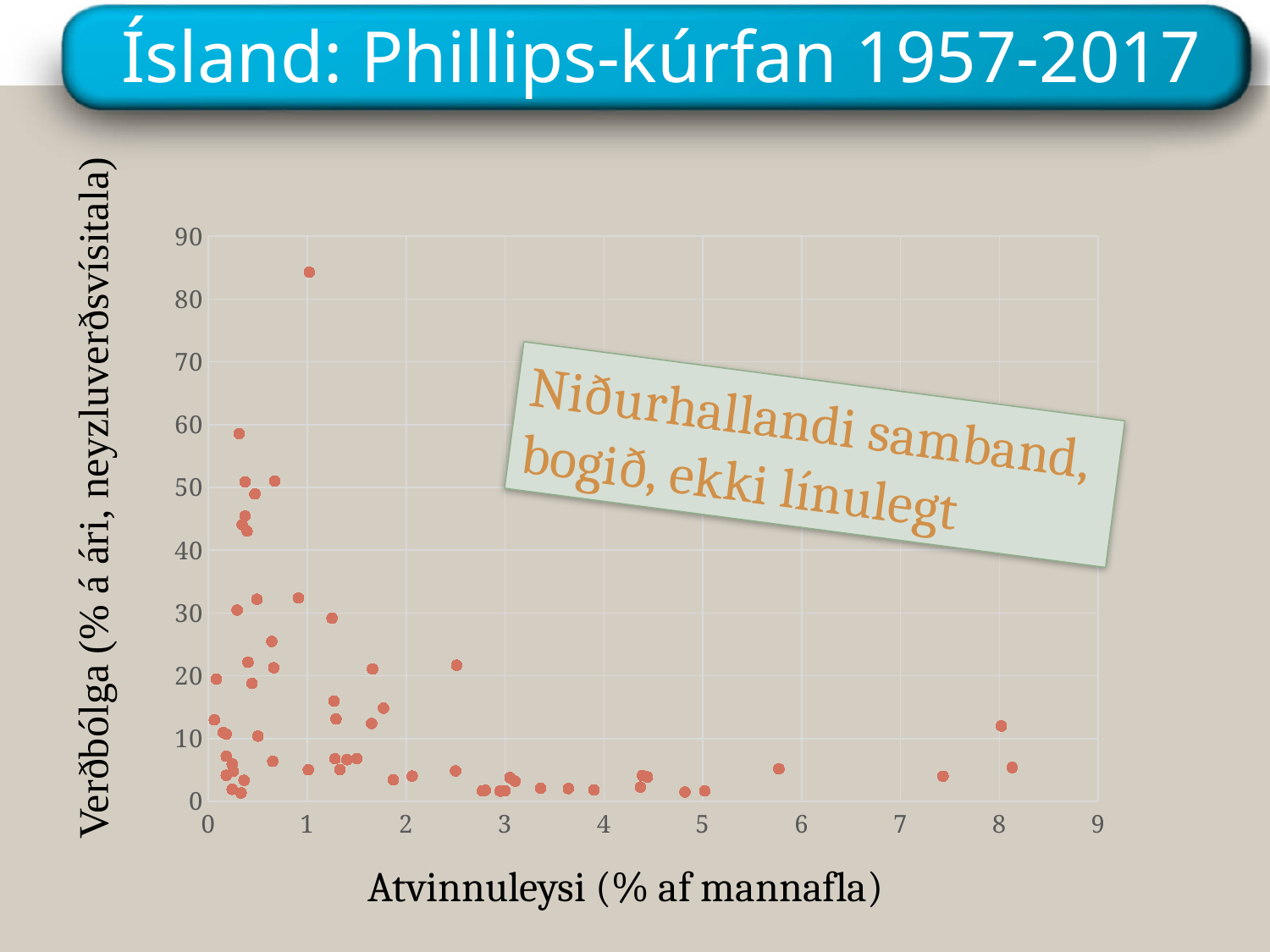
Does the point with the highest inflation lie at an unemployment rate greater or less than 2? less What kind of chart is shown on the slide? Scatter chart Is the inflation value for the point near 5.8% unemployment greater or less than 10? less Is the inflation value for the point near 2.5% unemployment that sits highest greater or less than 20? greater As unemployment (Atvinnuleysi) increases along the x axis, do the inflation values generally rise or fall? Fall What is the title of the x axis? Atvinnuleysi (% af mannafla) What text appears in the tilted annotation box on the chart? Niðurhallandi samband, bogið, ekki línulegt